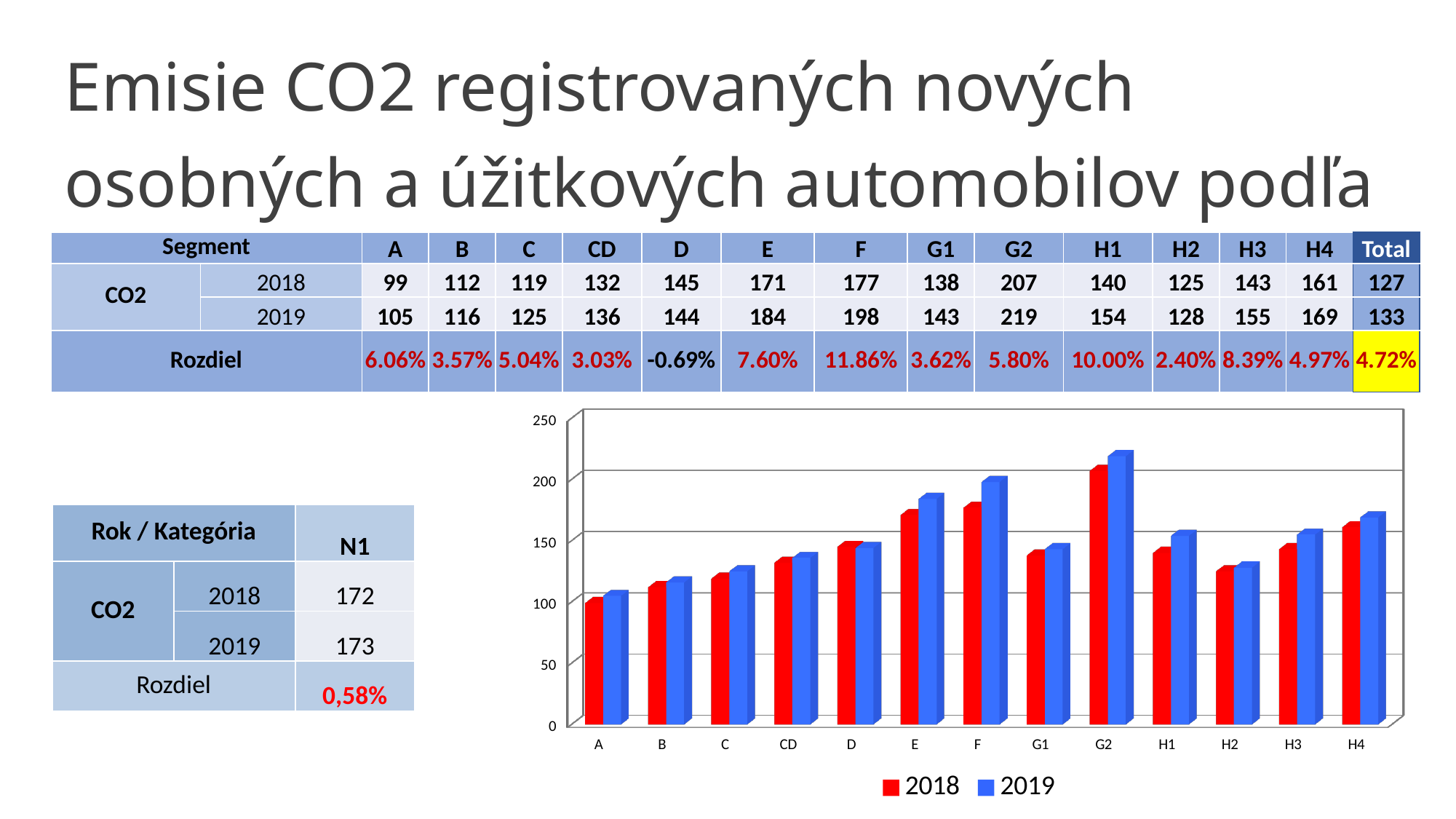
What kind of chart is shown on the slide? bar chart How many segment categories are shown on the x axis of the chart? 13 How many series does the chart legend list? 2 What is the 2019 value for segment G2? 219 Which is larger in the chart: the 2019 value for F or the 2019 value for E? F Is the 2019 value for E greater or less than 150? greater Which segment has the lowest 2018 value in the chart? A Is the 2018 value for H2 greater or less than 150? less Which colour represents the 2019 series in the chart? blue What is the difference between the 2019 and 2018 values for segment F? 21 Which segment has the highest 2019 value in the chart? G2 Is the 2019 value for G2 greater or less than 200? greater